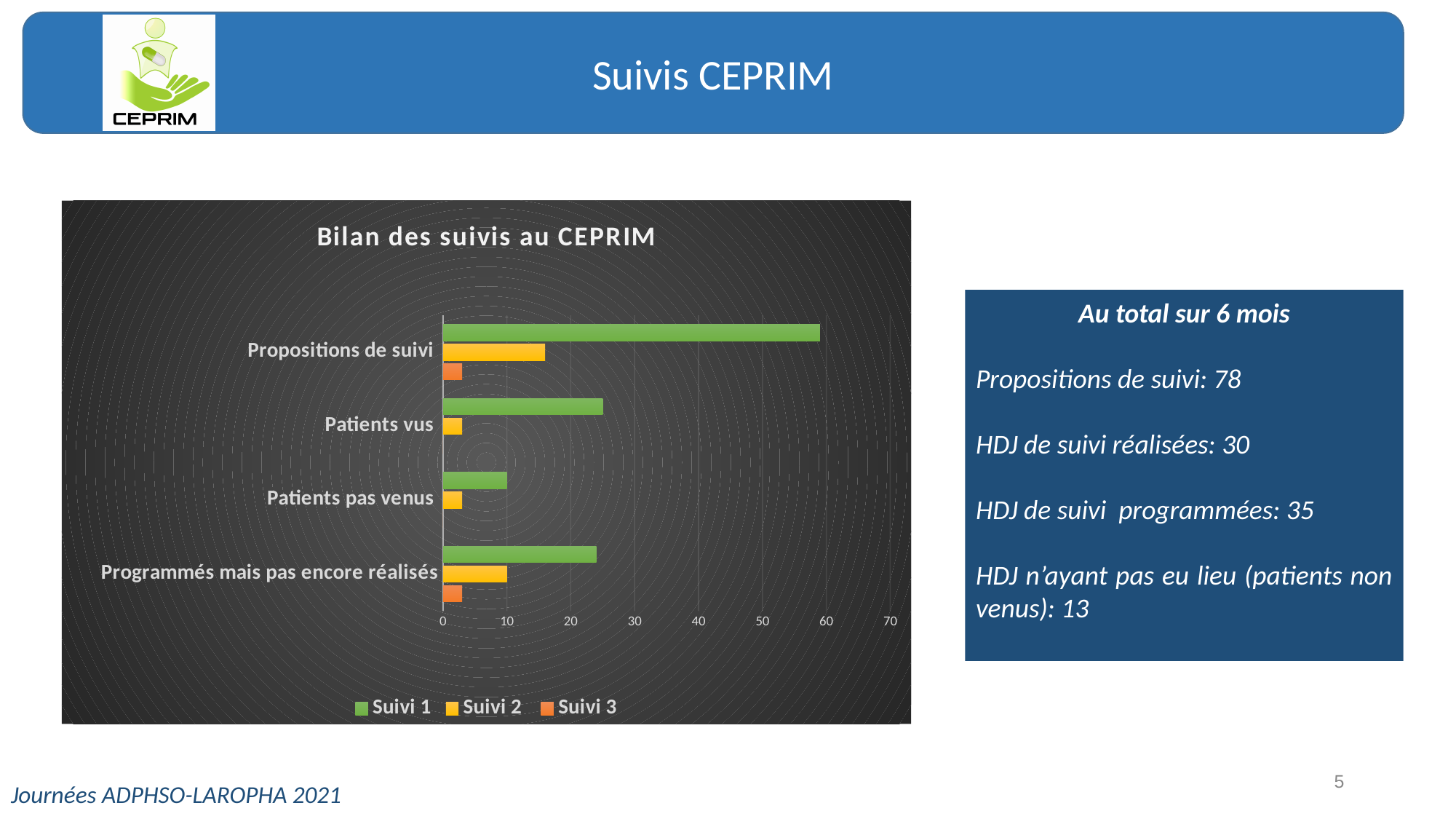
What is the title of the chart? Bilan des suivis au CEPRIM What kind of chart is shown on the slide? Bar chart Is the Suivi 1 value for Patients vus greater or less than 20? greater How many categories are shown on the chart's vertical axis? 4 For Suivi 2, which is larger: Propositions de suivi or Programmés mais pas encore réalisés? Propositions de suivi Is the Suivi 1 value for Patients pas venus greater or less than 20? less Which category has the highest value for Suivi 1? Propositions de suivi Which colour represents Suivi 3 in the chart legend? Orange Is the Suivi 1 value for Propositions de suivi greater or less than 50? greater Which category has the lowest value for Suivi 1? Patients pas venus How many series does the chart legend list? 3